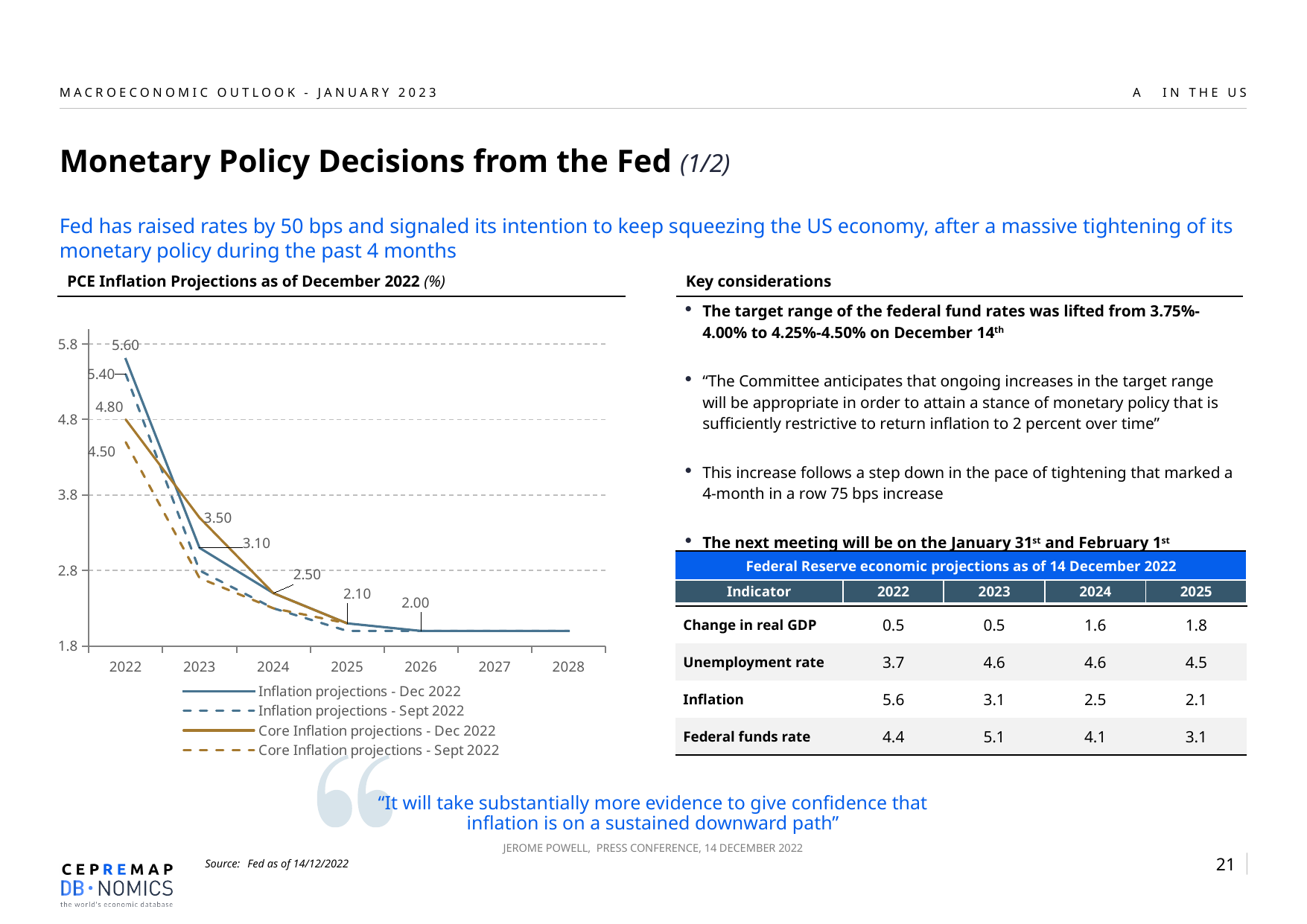
What kind of chart is shown on the slide? line chart Which is larger in 2022: Inflation projections - Dec 2022 or Inflation projections - Sept 2022? Inflation projections - Dec 2022 What is the value of the Core Inflation projections - Sept 2022 series for 2022? 4.50 Which series has the highest value in 2022? Inflation projections - Dec 2022 How many series does the chart legend list? 4 What is the value of the Core Inflation projections - Dec 2022 series for 2022? 4.80 Is the value of the Inflation projections - Dec 2022 series for 2028 greater or less than 2.8? less What is the difference between the 2022 values of Inflation projections - Dec 2022 and Core Inflation projections - Dec 2022? 0.80 How many years are shown on the x axis of the chart? 7 Do the projection lines rise or fall from 2022 to 2026? fall What is the value of the Inflation projections - Sept 2022 series for 2022? 5.40 What is the value of the Inflation projections - Dec 2022 series for 2022? 5.60